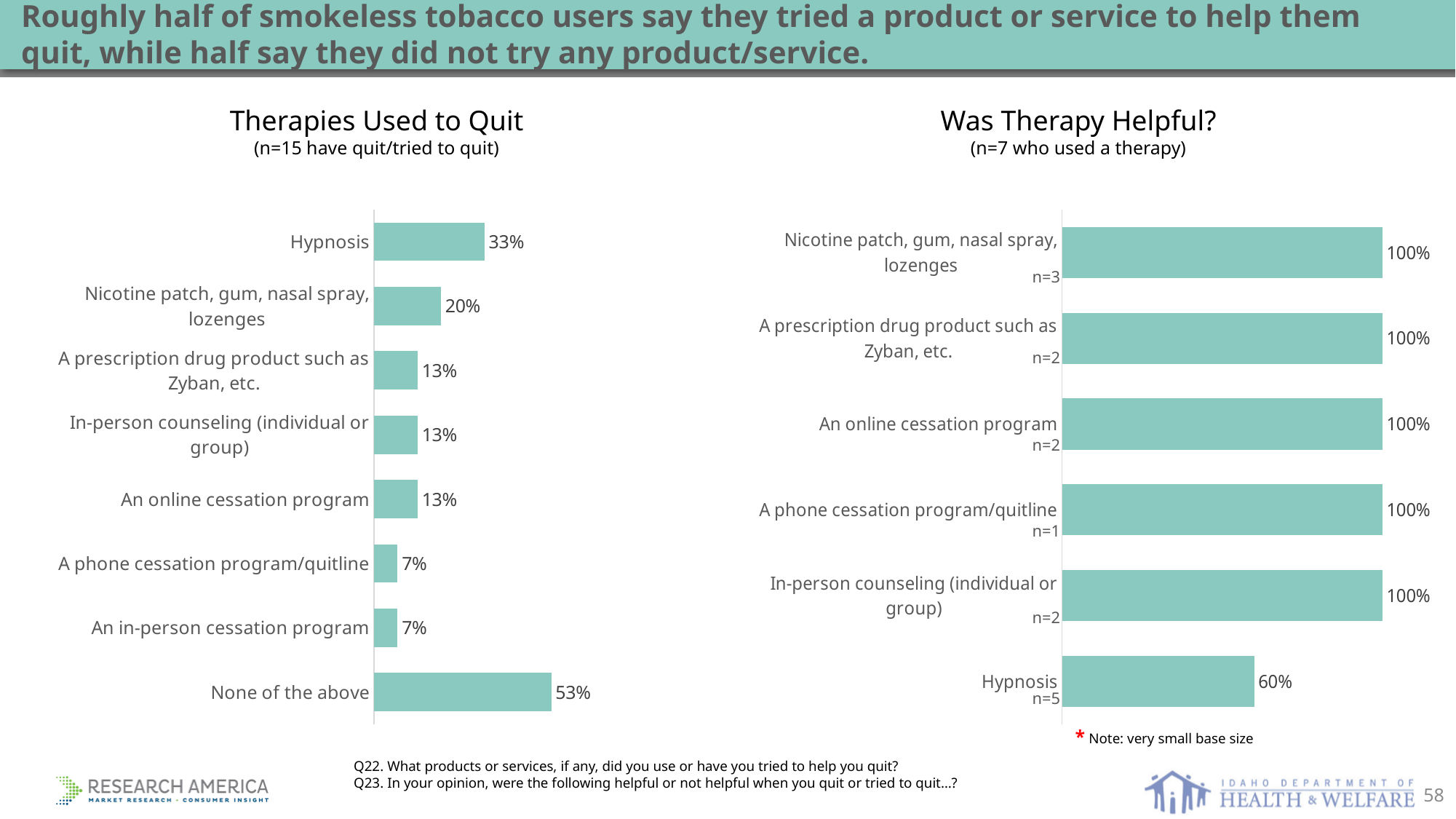
In the 'Was Therapy Helpful?' chart, what is the difference between 'An online cessation program' and 'Hypnosis'? 40% In the 'Therapies Used to Quit' chart, which category has the highest value? None of the above In the 'Therapies Used to Quit' chart, which is larger: 'Nicotine patch, gum, nasal spray, lozenges' or 'A phone cessation program/quitline'? Nicotine patch, gum, nasal spray, lozenges In the 'Therapies Used to Quit' chart, what is the difference between 'None of the above' and 'Hypnosis'? 20% How many categories are shown in the 'Was Therapy Helpful?' chart? 6 In the 'Was Therapy Helpful?' chart, which category has the lowest value? Hypnosis In the 'Was Therapy Helpful?' chart, what percentage found hypnosis helpful? 60% How many categories are shown in the 'Therapies Used to Quit' chart? 8 What type of chart is the 'Was Therapy Helpful?' chart? Bar chart In the 'Therapies Used to Quit' chart, what percentage selected 'None of the above'? 53% In the 'Was Therapy Helpful?' chart, what is the base size (n) shown for Hypnosis? n=5 In the 'Therapies Used to Quit' chart, what percentage used hypnosis? 33%